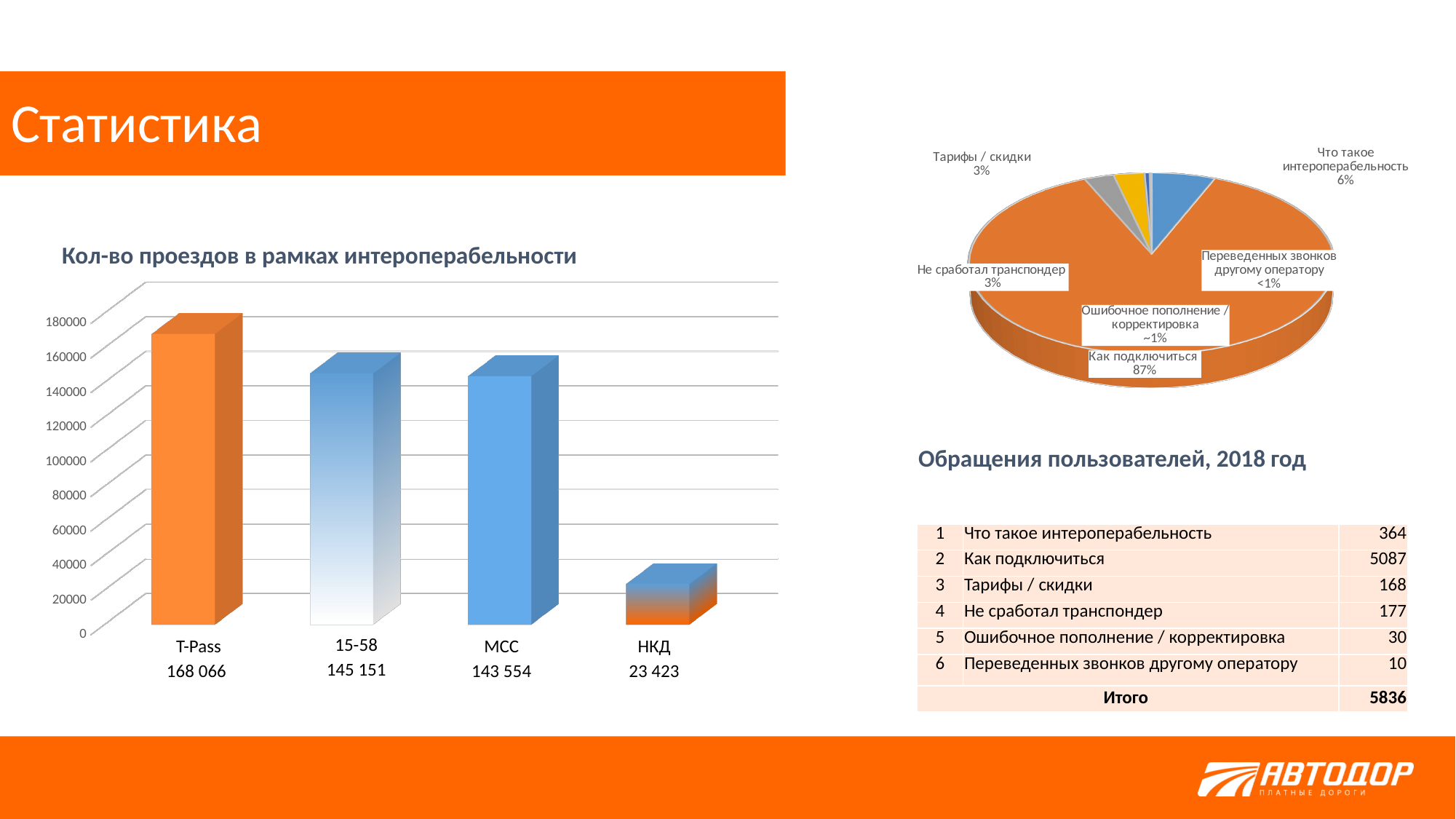
In the pie chart 'Обращения пользователей, 2018 год', what share does 'Что такое интероперабельность' have? 6% In the bar chart 'Кол-во проездов в рамках интероперабельности', what is the value for T-Pass? 168 066 In the pie chart 'Обращения пользователей, 2018 год', what share does 'Как подключиться' have? 87% In the bar chart 'Кол-во проездов в рамках интероперабельности', which category has the highest value? T-Pass In the bar chart 'Кол-во проездов в рамках интероперабельности', what is the difference between the values for T-Pass and НКД? 144 643 In the pie chart 'Обращения пользователей, 2018 год', which slice is the largest? Как подключиться In the bar chart 'Кол-во проездов в рамках интероперабельности', what is the value for НКД? 23 423 In the bar chart 'Кол-во проездов в рамках интероперабельности', which category has the lowest value? НКД What kind of chart is 'Кол-во проездов в рамках интероперабельности'? bar chart In the bar chart 'Кол-во проездов в рамках интероперабельности', which is larger: the value for 15-58 or the value for МСС? 15-58 In the bar chart 'Кол-во проездов в рамках интероперабельности', how many categories are shown? 4 What kind of chart is 'Обращения пользователей, 2018 год'? pie chart